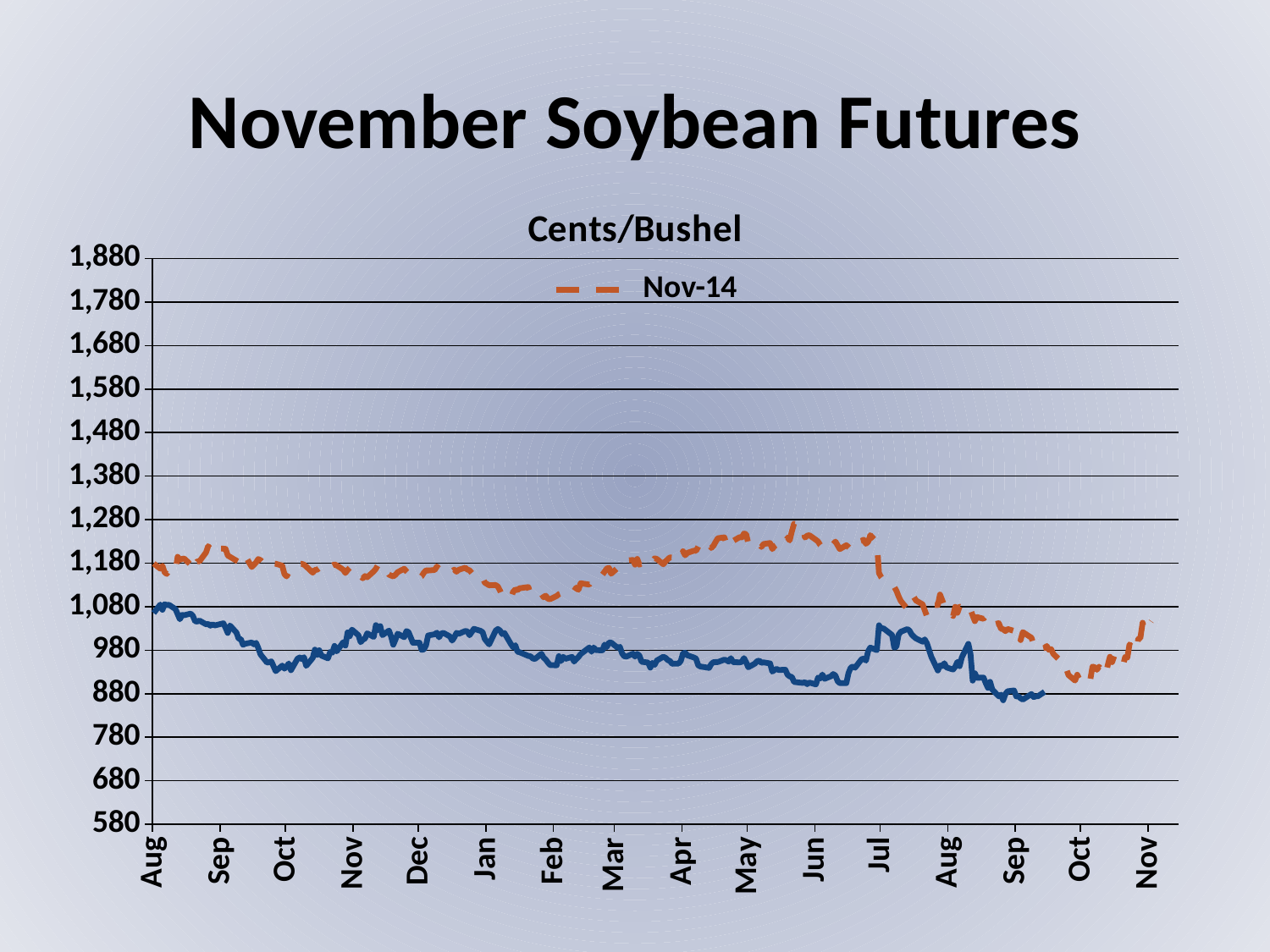
Is the Nov-14 value at the final Nov point greater or less than 980? greater Is the Nov-14 value at Jun greater or less than 1,180? greater What kind of chart is shown on the slide? line chart What is the highest value shown on the y axis? 1,880 What is the name of the series listed in the legend? Nov-14 Does the Nov-14 line rise or fall between Feb and May? rise Is the Nov-14 value at Oct greater or less than 980? less How many month labels are shown along the x axis? 16 What is the title shown above the chart's plot area? Cents/Bushel How many series does the chart's legend list? 1 Does the Nov-14 line rise or fall between Jun and Oct? fall